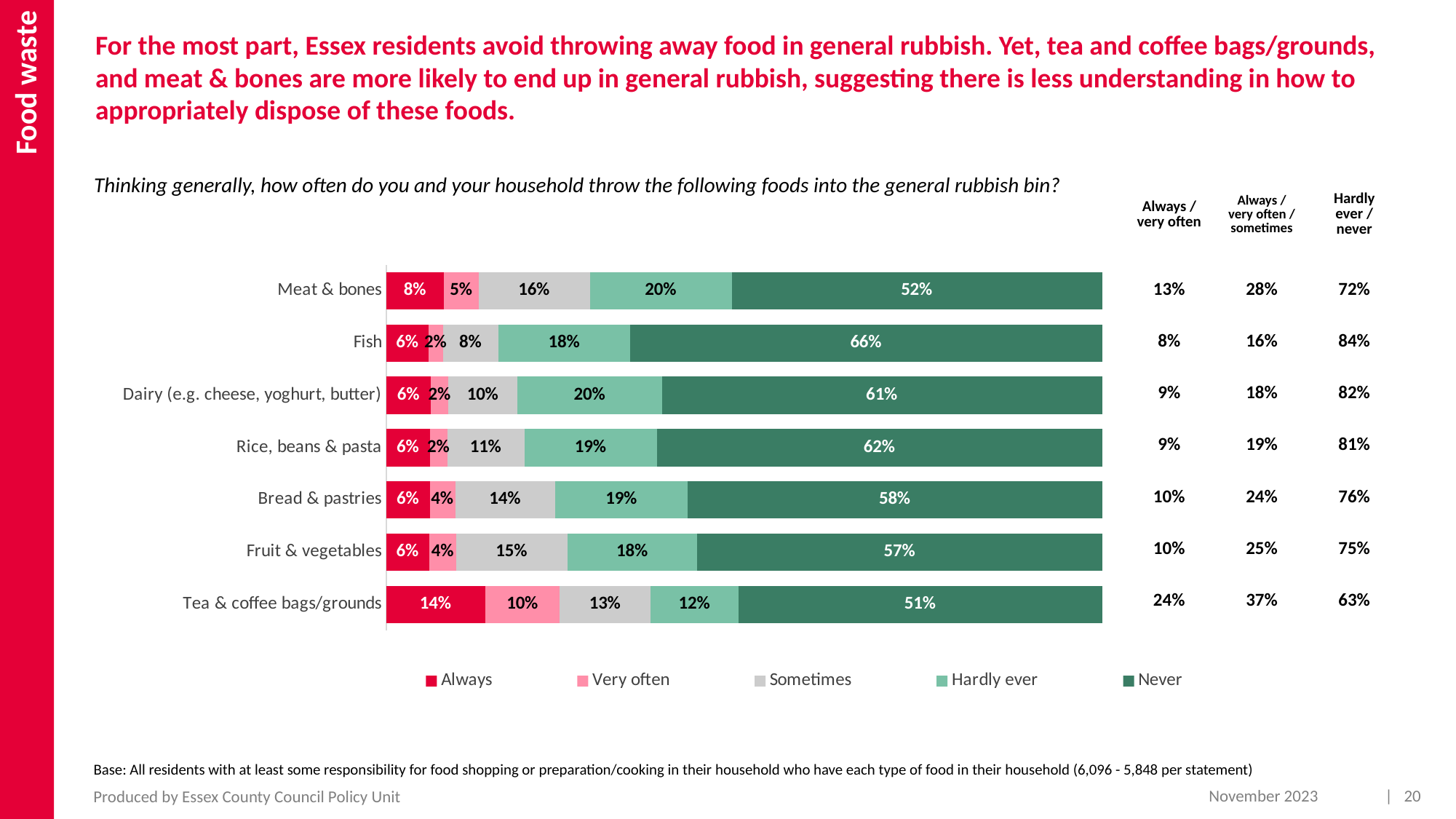
What is the 'Always' value for Tea & coffee bags/grounds? 14% What kind of chart is shown on the slide? Stacked bar chart How many series does the legend list? 5 What percentage of respondents say they 'Never' throw fish into the general rubbish bin? 66% Which food has the highest 'Very often' percentage? Tea & coffee bags/grounds Which food has the highest 'Never' percentage? Fish What is the total of the stacked bar for Fish? 100% What is the difference between the 'Never' value for Fish and the 'Never' value for Meat & bones? 14 percentage points Which has a larger 'Sometimes' value: Meat & bones or Fruit & vegetables? Meat & bones What is the 'Hardly ever' value for Dairy (e.g. cheese, yoghurt, butter)? 20% Which food has the lowest 'Never' percentage? Tea & coffee bags/grounds How many food categories are shown in the chart? 7